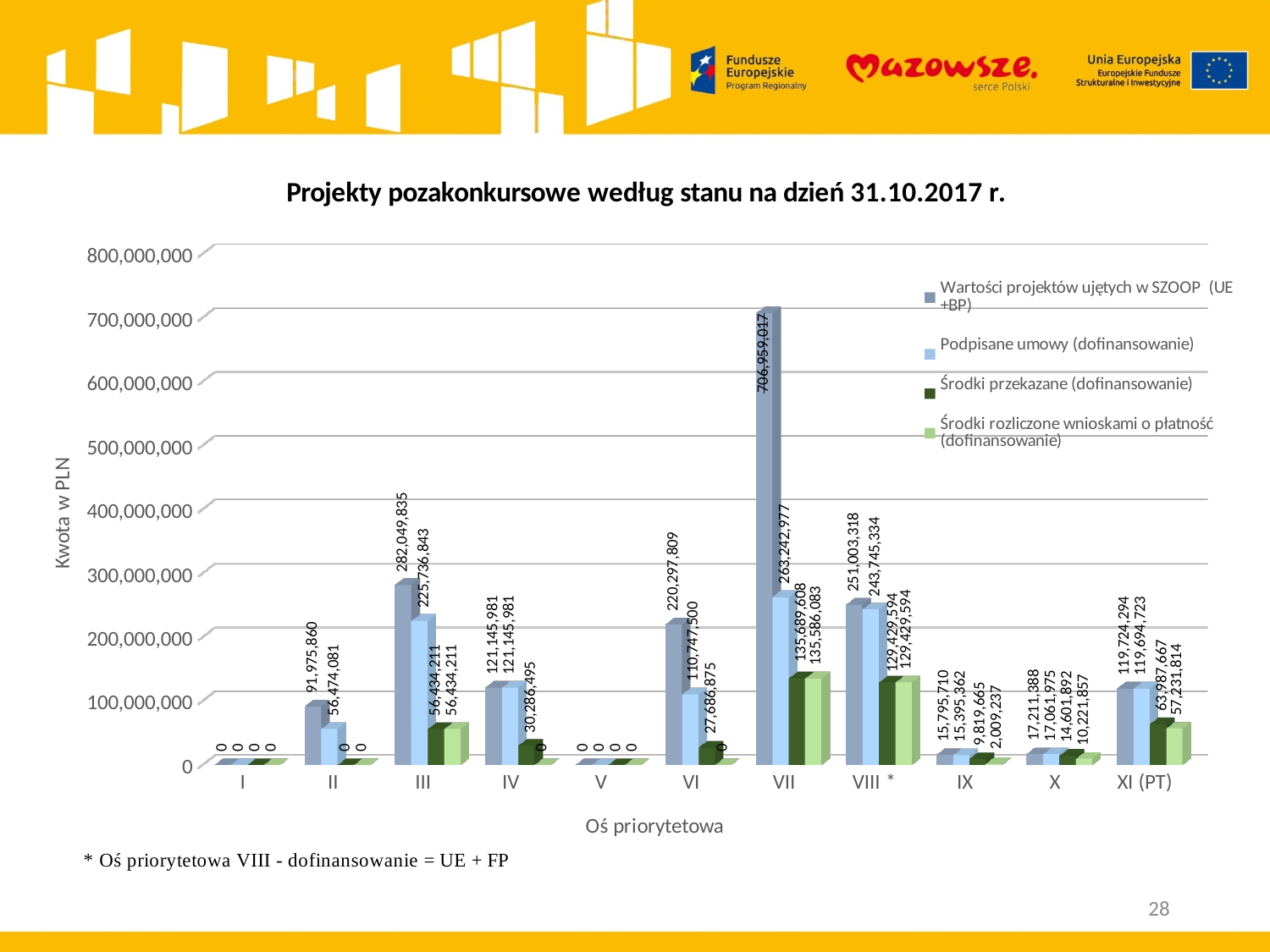
What is the value of 'Wartości projektów ujętych w SZOOP (UE+BP)' for priority axis VII? 706,959,017 How many priority axes (categories) are shown on the x axis? 11 How many series does the legend list? 4 What is the value of 'Podpisane umowy (dofinansowanie)' for priority axis III? 225,736,843 Is the value of 'Podpisane umowy (dofinansowanie)' for priority axis VIII * greater or less than 200,000,000? greater What is the value of 'Środki rozliczone wnioskami o płatność (dofinansowanie)' for priority axis IX? 2,009,237 What kind of chart is shown on the slide? Bar chart Which is larger for priority axis VI: 'Podpisane umowy (dofinansowanie)' or 'Środki przekazane (dofinansowanie)'? Podpisane umowy (dofinansowanie) What is the value of 'Środki przekazane (dofinansowanie)' for priority axis XI (PT)? 63,987,667 Which priority axis has the highest value of 'Wartości projektów ujętych w SZOOP (UE+BP)'? VII What is the difference between 'Wartości projektów ujętych w SZOOP (UE+BP)' and 'Podpisane umowy (dofinansowanie)' for priority axis VII? 443,716,040 What is the label of the vertical axis? Kwota w PLN